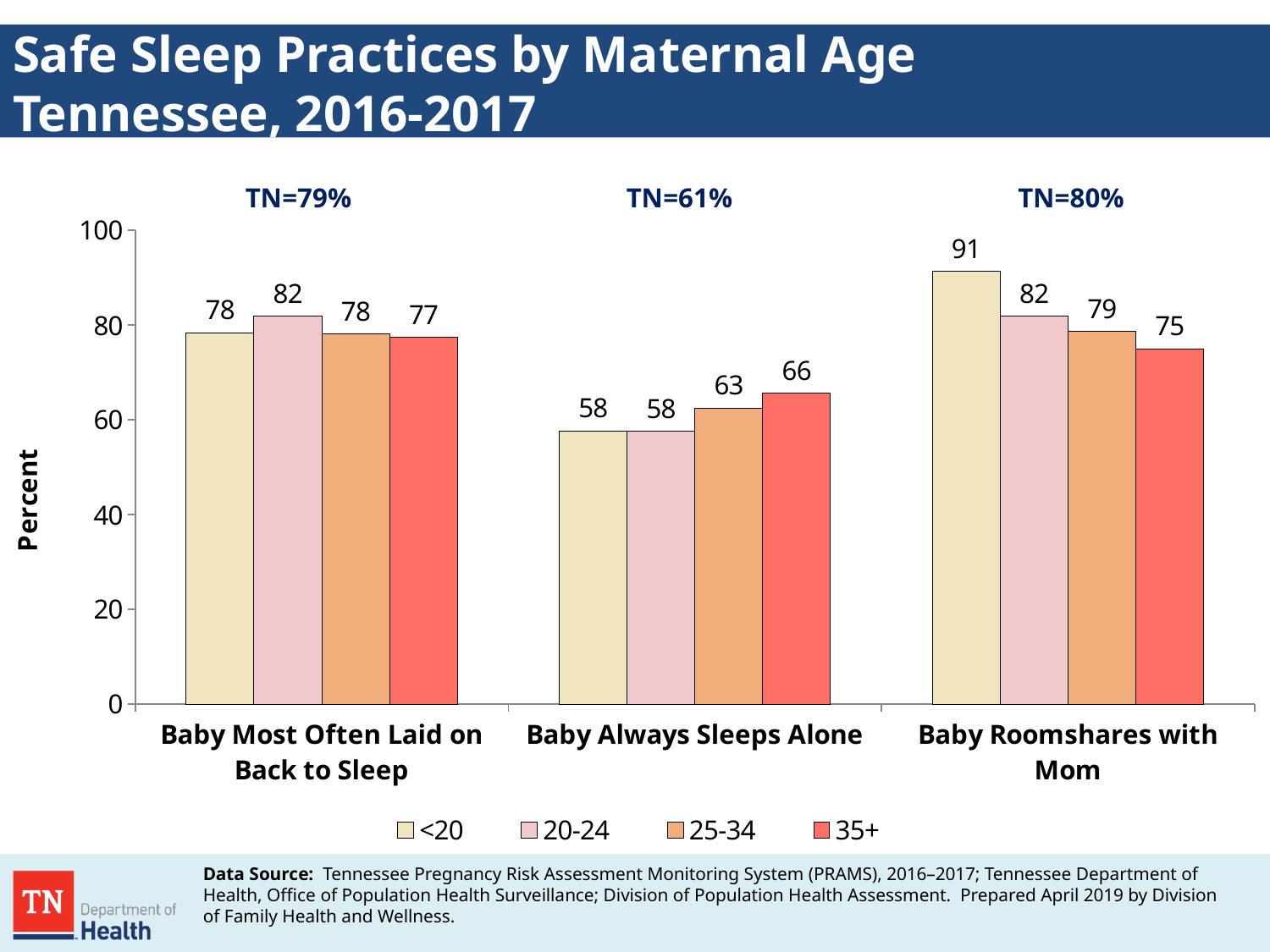
What is the value for the 35+ age group for Baby Always Sleeps Alone? 66 How many series does the legend list? 4 What is the value for the 20-24 age group for Baby Most Often Laid on Back to Sleep? 82 Which is larger for Baby Always Sleeps Alone: the 25-34 value or the 35+ value? 35+ How many safe sleep practice categories are shown on the x axis? 3 Which age group has the lowest value for Baby Roomshares with Mom? 35+ What is the label on the y axis? Percent Which age group has the highest value for Baby Roomshares with Mom? <20 What kind of chart is shown on the slide? Bar chart What is the value for the <20 age group for Baby Roomshares with Mom? 91 What is the overall Tennessee percentage shown above the Baby Always Sleeps Alone group? TN=61% What is the difference between the <20 and 35+ values for Baby Roomshares with Mom? 16